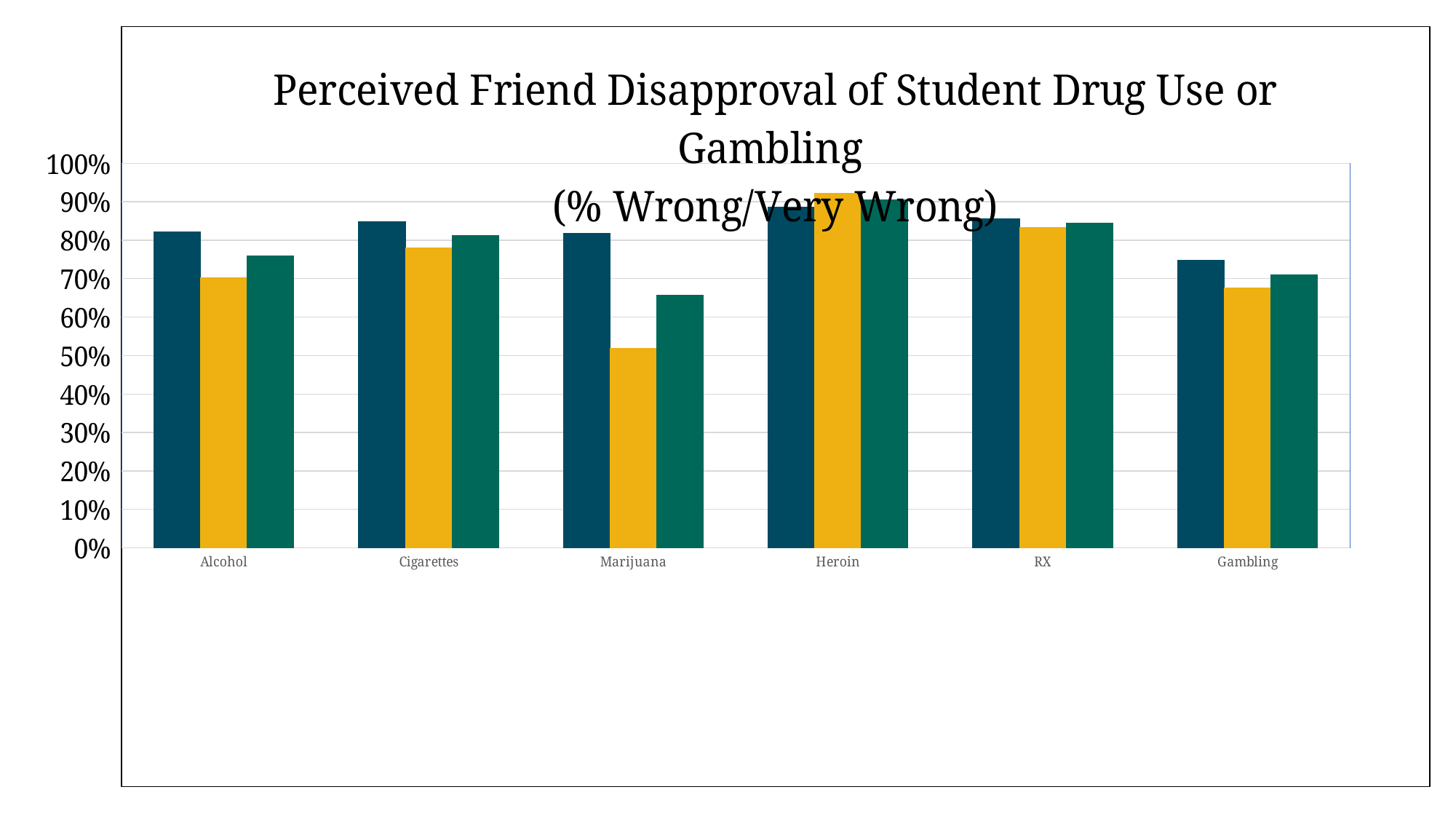
What kind of chart is shown on the slide? bar chart For Marijuana, which is larger: the yellow bar or the green bar? the green bar Is the yellow bar for Heroin greater or less than 90%? greater How many categories are shown along the x axis? 6 Is the dark blue bar for Cigarettes greater or less than 80%? greater Which category has the lowest dark blue bar? Gambling Is the yellow bar for Marijuana greater or less than 60%? less Which category has the lowest yellow bar? Marijuana Which category has the highest yellow bar? Heroin How many bars are plotted for each category? 3 Which category has the lowest green bar? Marijuana What is the title of the chart? Perceived Friend Disapproval of Student Drug Use or Gambling (% Wrong/Very Wrong)